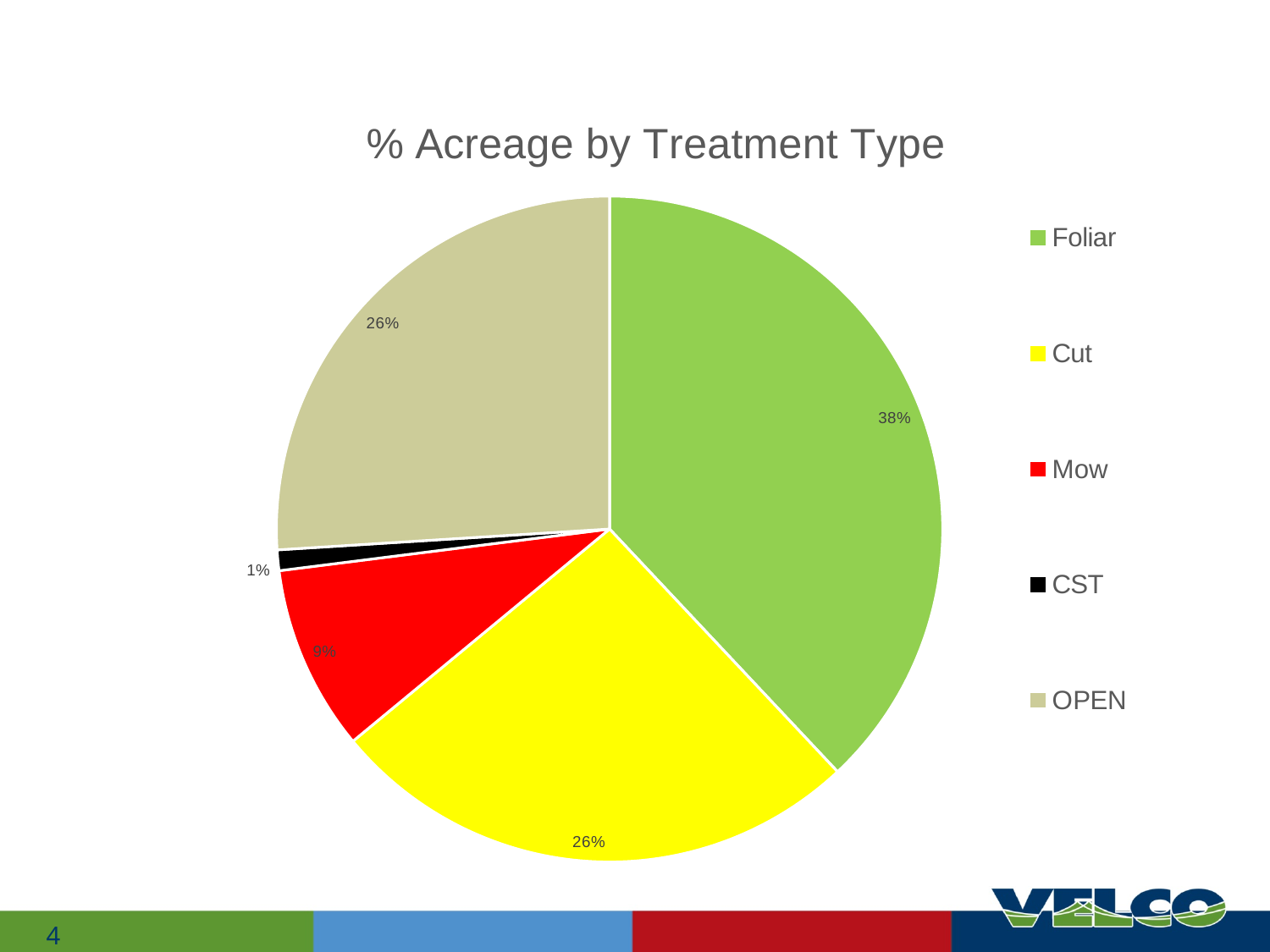
What colour represents the Cut slice in the pie chart? yellow What percentage of acreage is CST treatment? 1% Which treatment type has the largest share of acreage? Foliar What is the difference in percentage points between Foliar and Mow? 29 What type of chart is shown on the slide? pie chart What is the title of the chart? % Acreage by Treatment Type What percentage of acreage is Foliar treatment? 38% What percentage of acreage is Mow treatment? 9% How many treatment types are shown in the pie chart? 5 Which has a larger share of acreage, Mow or OPEN? OPEN What percentage of acreage is Cut treatment? 26% Which treatment type has the smallest share of acreage? CST